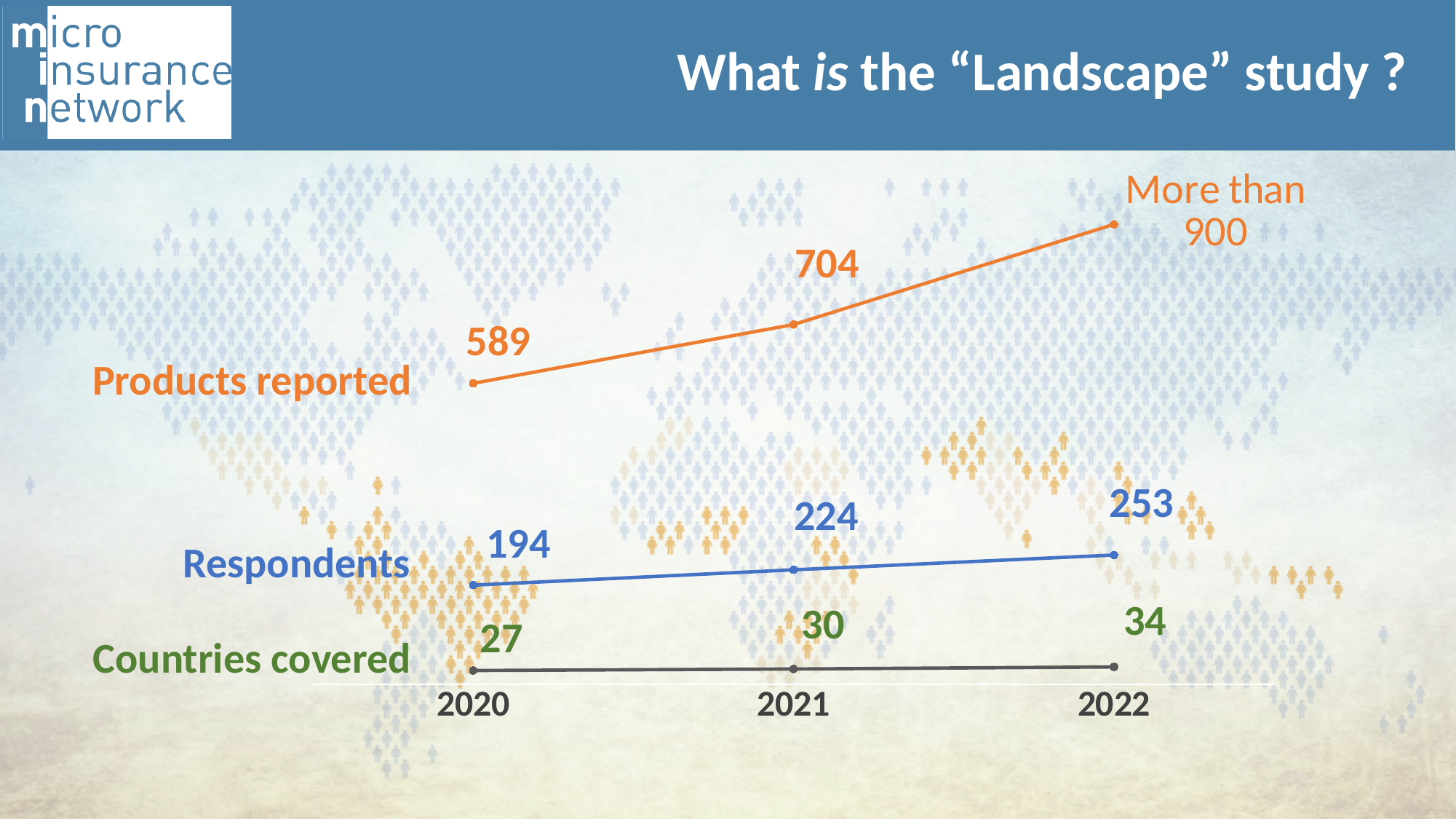
How many countries were covered in 2022? 34 What is the label for products reported in 2022? More than 900 How many products were reported in 2021? 704 In which year was the number of respondents highest? 2022 What is the difference in products reported between 2021 and 2020? 115 How many respondents were there in 2021? 224 In which year was the number of countries covered lowest? 2020 How many products were reported in 2020? 589 Does the number of products reported rise or fall from 2020 to 2022? Rise Which is larger: respondents in 2021 or countries covered in 2021? Respondents in 2021 How many years are shown on the x axis? 3 What is the difference in respondents between 2022 and 2020? 59